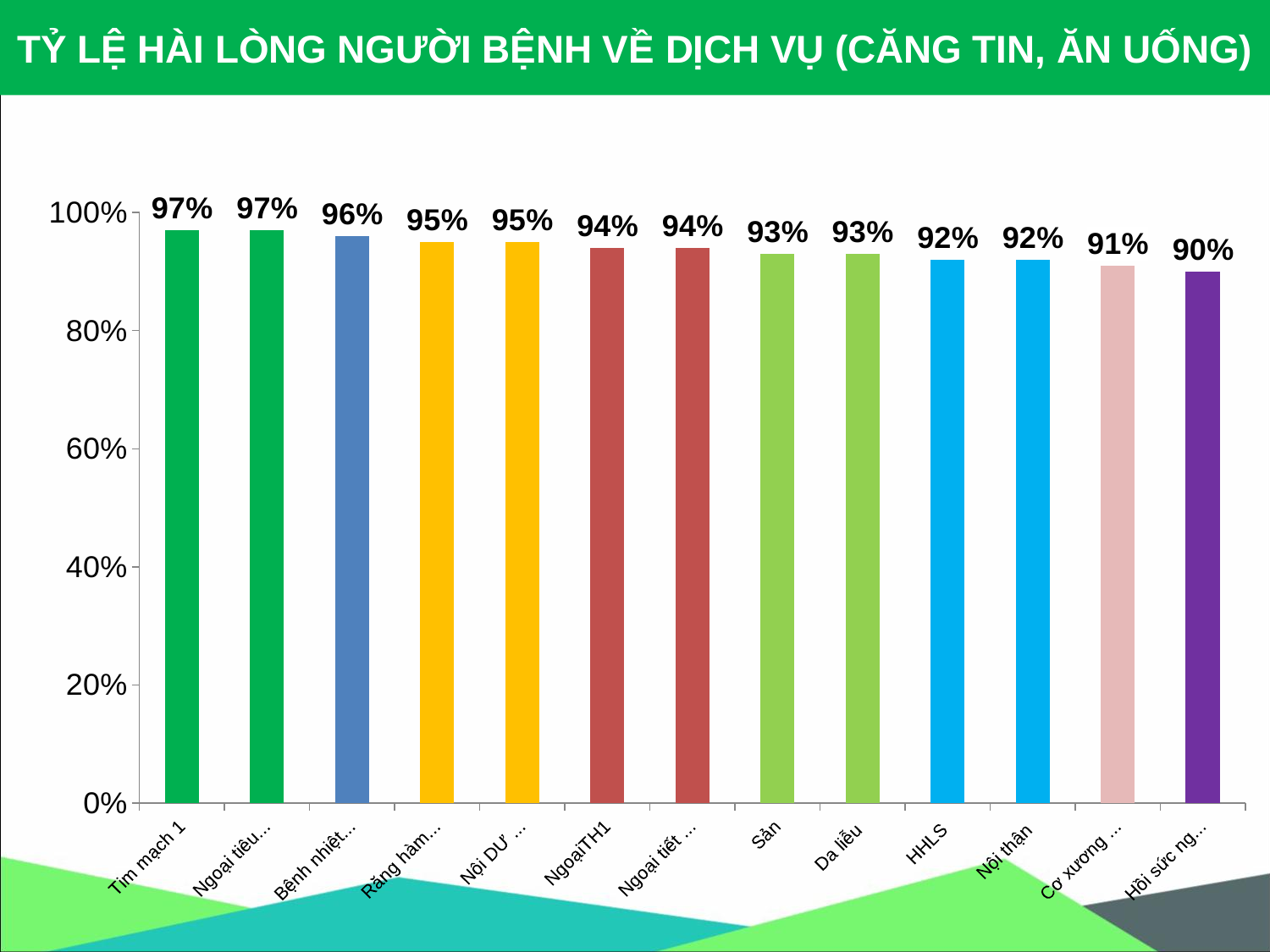
What is the value for HHLS? 92% What is the lowest value shown in the chart? 90% What is the value for NgoạiTH1? 94% What is the value for Tim mạch 1? 97% What is the value for Nội thận? 92% Do the values rise or fall from left to right along the x axis? Fall What is the difference between the values for Tim mạch 1 and Da liễu? 4% How many bars are in the chart? 13 What kind of chart is shown on the slide? Bar chart What is the value for Sản? 93% Which is larger, the value for NgoạiTH1 or the value for HHLS? NgoạiTH1 What is the highest value shown in the chart? 97%